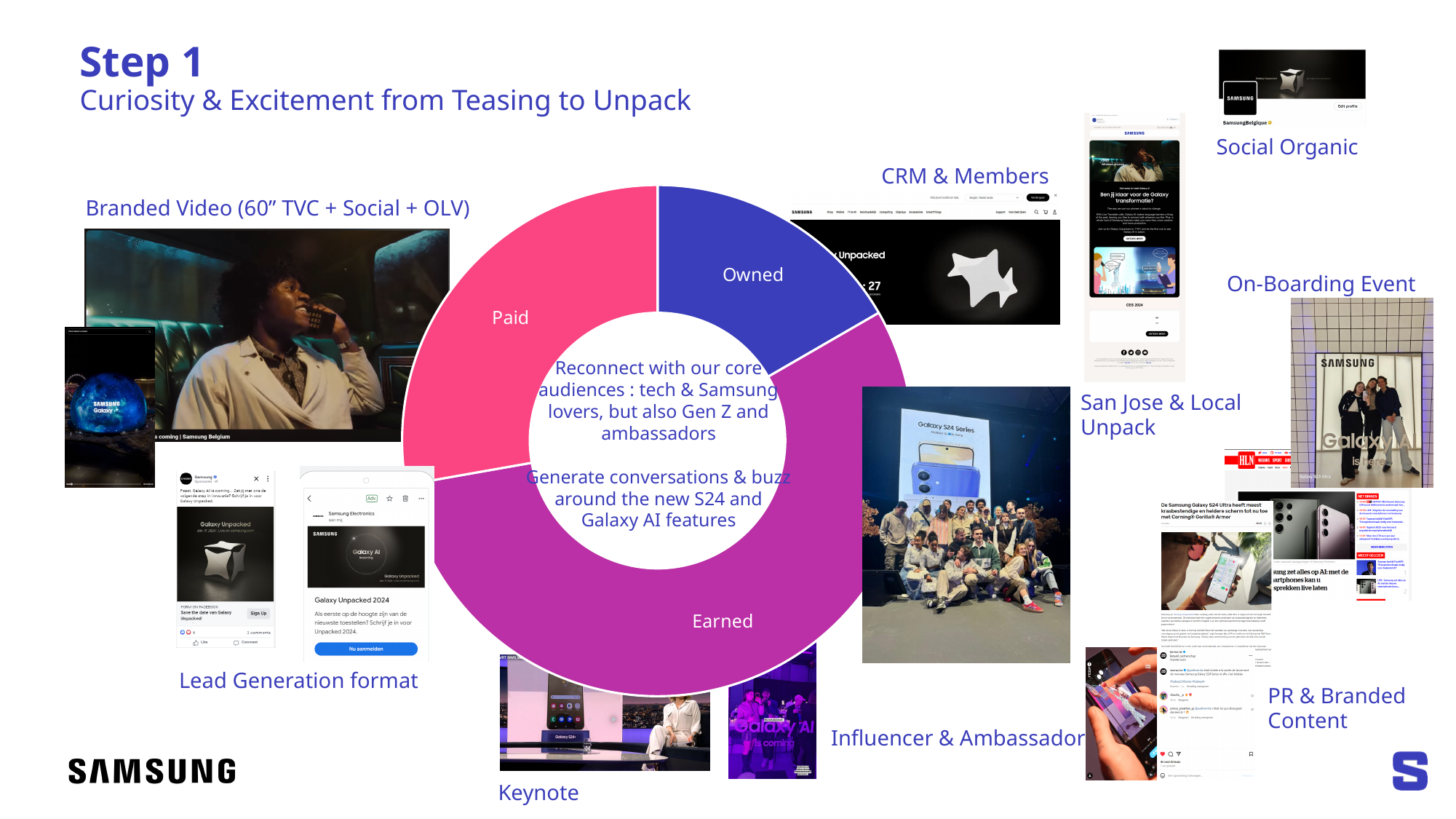
Which segment of the donut chart is larger, Earned or Paid? Earned Which segment of the donut chart is larger, Paid or Owned? Paid Which segment of the donut chart is the smallest? Owned Which segment of the donut chart is the largest? Earned What kind of chart is shown in the centre of the slide? Donut chart How many segments does the donut chart have? 3 What are the labels of the three segments in the donut chart? Paid, Owned, Earned What colour is the Owned segment of the donut chart? Blue